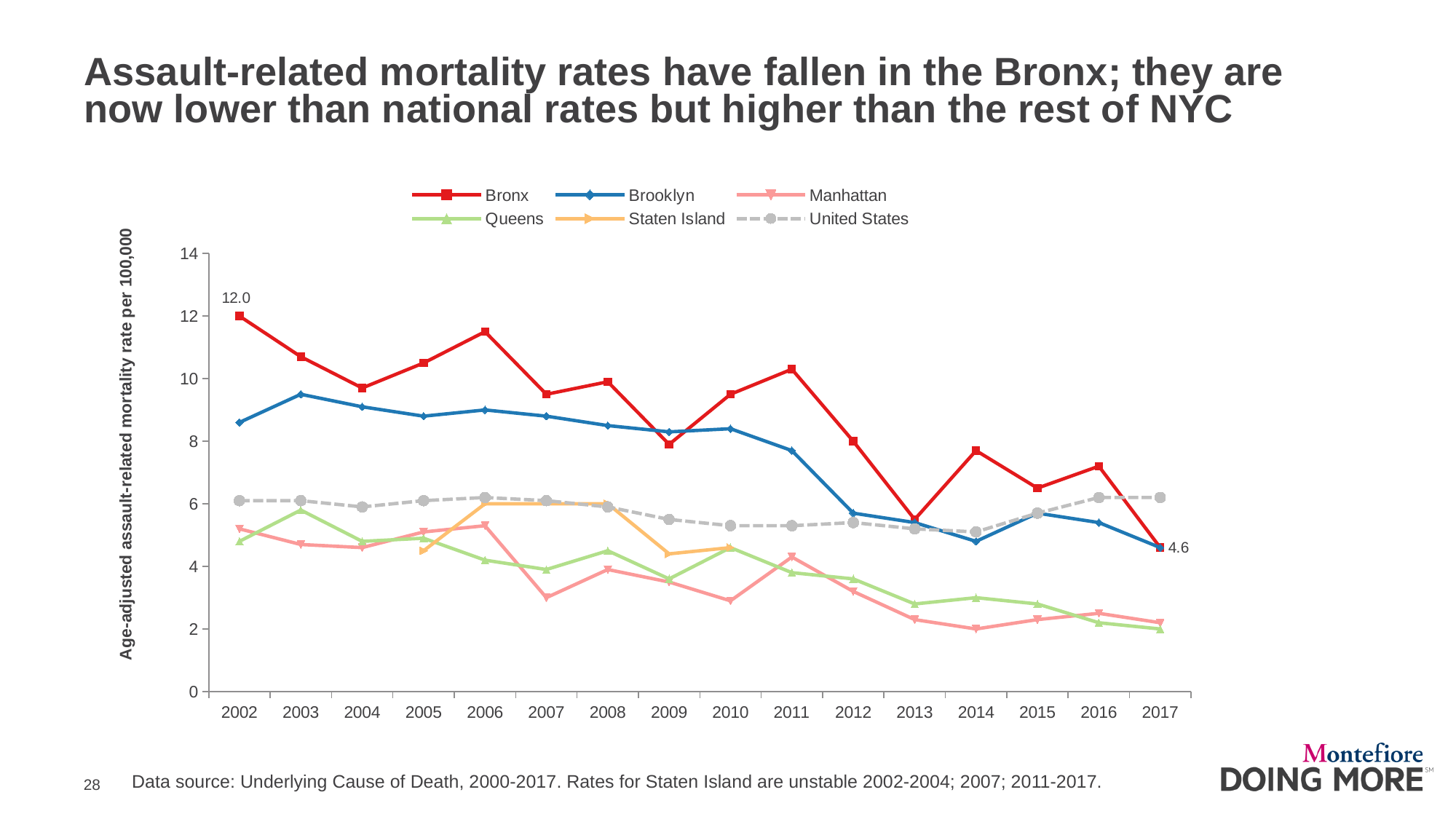
How many years are shown on the x axis? 16 Which series has the highest value in 2002? Bronx Is the Bronx value for 2006 greater or less than 10? greater Is the Manhattan value for 2014 greater or less than 4? less What kind of chart is shown on the slide? Line chart Does the Bronx rate generally rise or fall from 2002 to 2017? Fall Which series is drawn with a dashed line? United States What is the Bronx assault-related mortality rate in 2017? 4.6 How many series does the legend list? 6 By how much did the Bronx rate fall between 2002 and 2017? 7.4 In 2002, which is higher: the Bronx rate or the Brooklyn rate? Bronx What is the Bronx assault-related mortality rate in 2002? 12.0